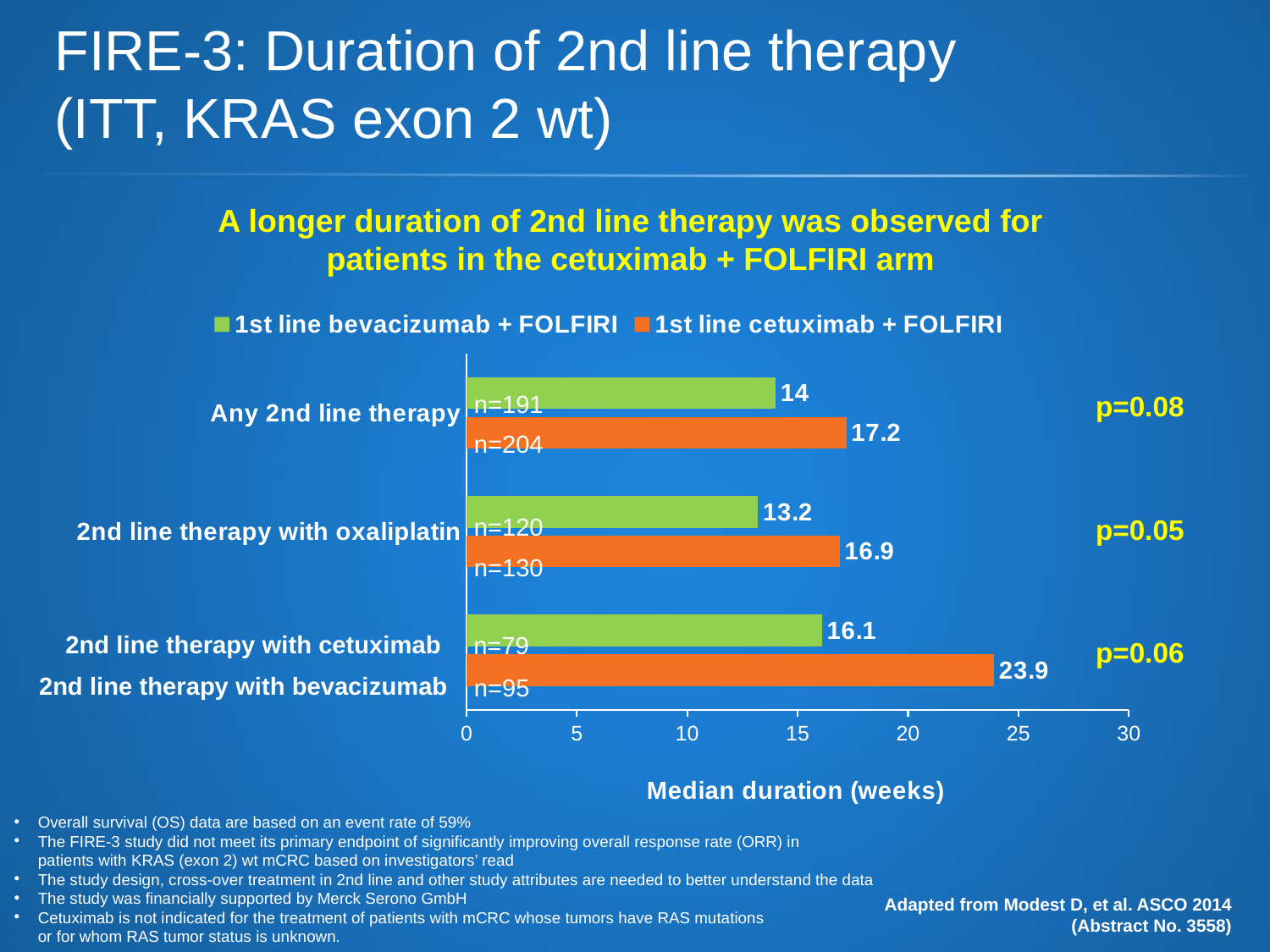
What p-value is shown next to the '2nd line therapy with oxaliplatin' bars? p=0.05 What is the median duration (weeks) for 'Any 2nd line therapy' in the 1st line bevacizumab + FOLFIRI arm? 14 What is the median duration (weeks) for '2nd line therapy with oxaliplatin' in the 1st line bevacizumab + FOLFIRI arm? 13.2 For '2nd line therapy with oxaliplatin', which arm has the longer median duration? 1st line cetuximab + FOLFIRI How many series does the legend list? 2 What is the median duration (weeks) for '2nd line therapy with oxaliplatin' in the 1st line cetuximab + FOLFIRI arm? 16.9 What is the median duration (weeks) for 'Any 2nd line therapy' in the 1st line cetuximab + FOLFIRI arm? 17.2 What is the difference in median duration (weeks) between the two arms for the bottom category (2nd line therapy with cetuximab/bevacizumab)? 7.8 What kind of chart is shown on the slide? Bar chart What is the difference in median duration (weeks) between the two arms for 'Any 2nd line therapy'? 3.2 Which bar has the highest median duration on the chart? 1st line cetuximab + FOLFIRI, 2nd line therapy with cetuximab/bevacizumab (23.9) Which bar has the lowest median duration on the chart? 1st line bevacizumab + FOLFIRI, 2nd line therapy with oxaliplatin (13.2)